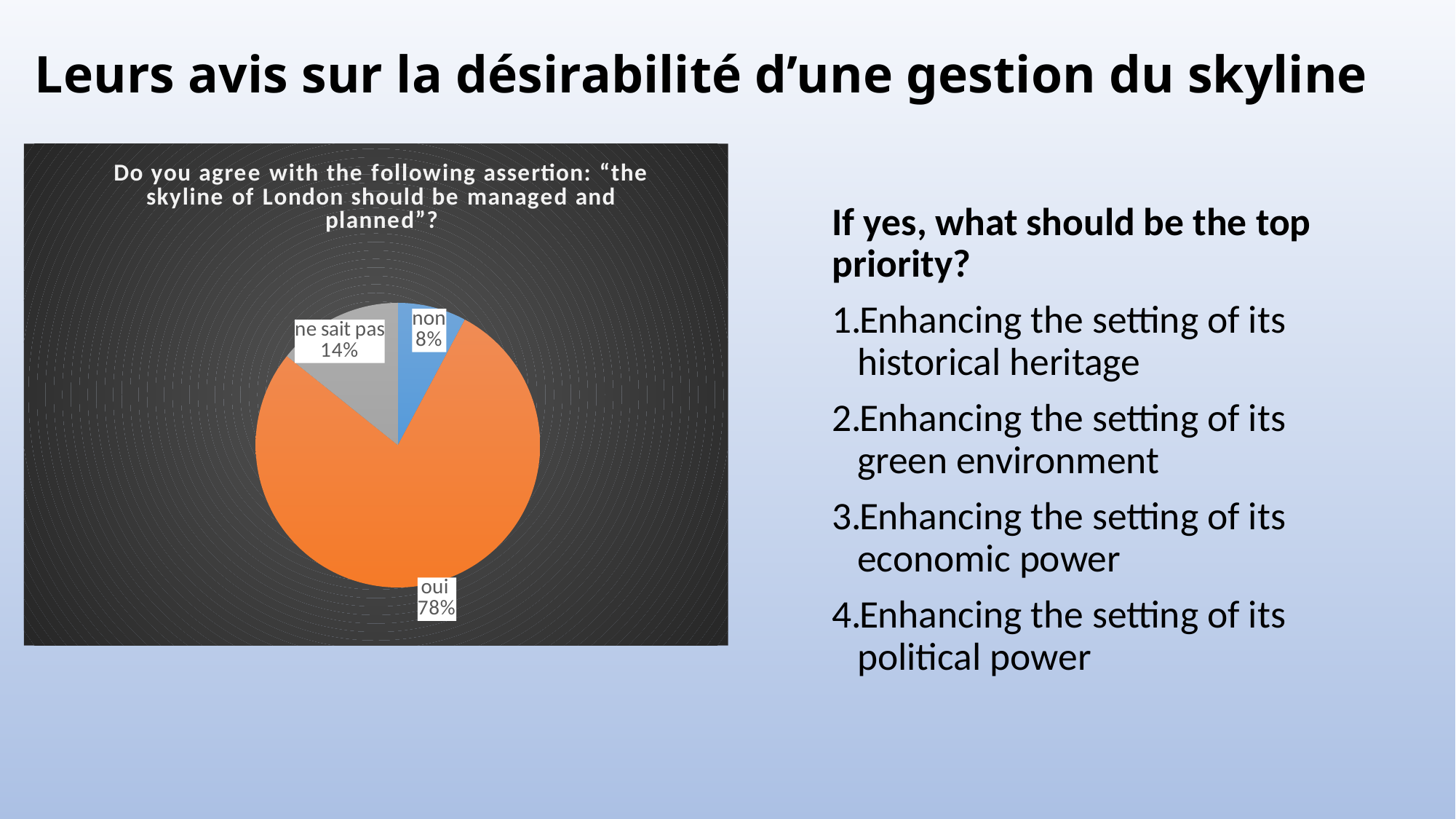
Which is larger, the share for "ne sait pas" or the share for "non"? ne sait pas What percentage of respondents answered "non"? 8% Which response has the smallest share of the pie? non Which response has the largest share of the pie? oui What is the difference in percentage points between "ne sait pas" and "non"? 6 What kind of chart is shown on the slide? pie chart What is the difference in percentage points between "oui" and "non"? 70 What percentage of respondents answered "oui"? 78% What colour is the "oui" slice of the pie chart? orange How many slices does the pie chart have? 3 What percentage of respondents answered "ne sait pas"? 14% What is the title of the pie chart? Do you agree with the following assertion: "the skyline of London should be managed and planned"?